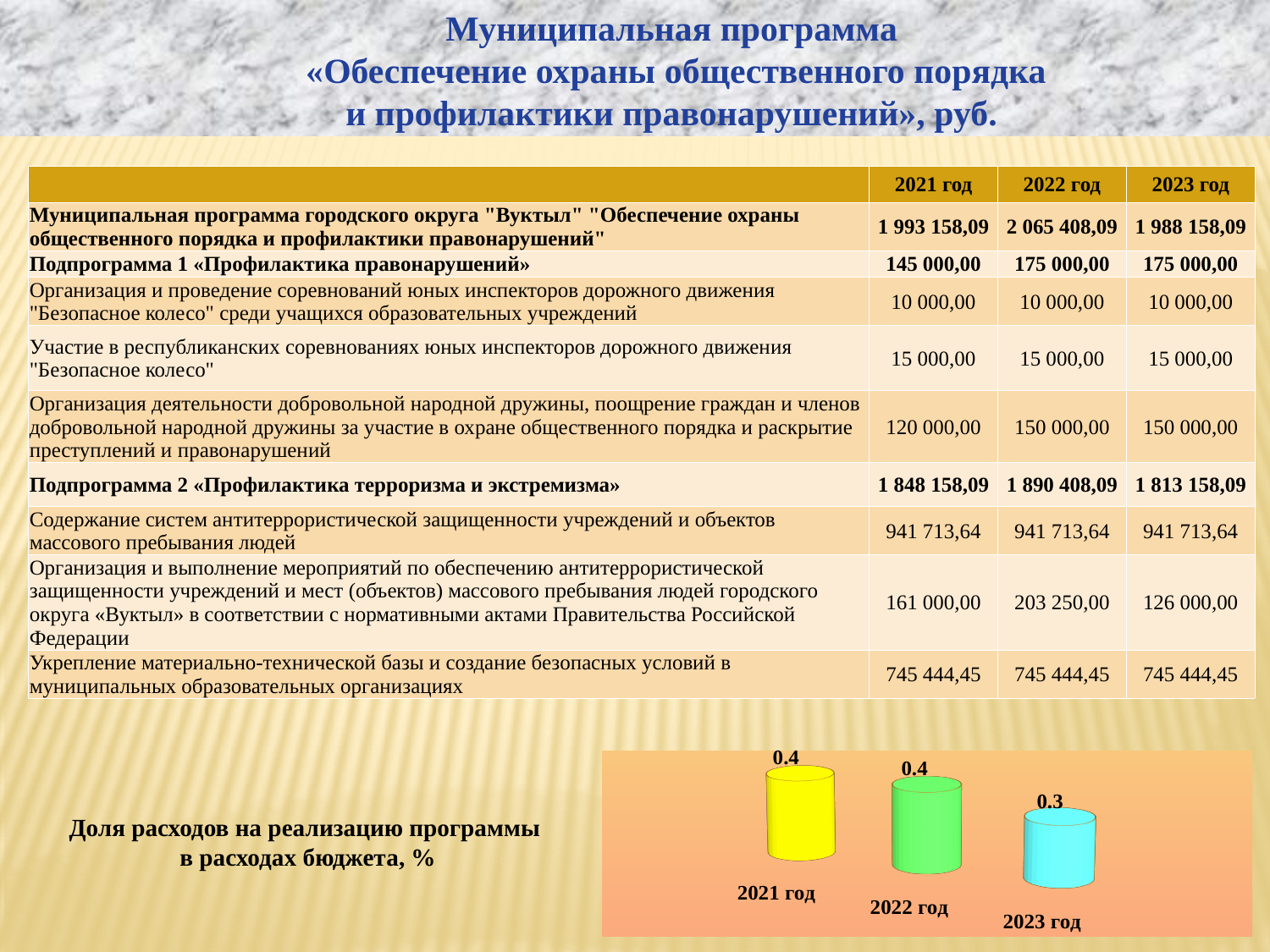
What colour is the bar for 2021 год? Yellow What kind of chart is shown at the bottom of the slide? Bar chart Which is larger, the value for 2022 год or the value for 2023 год? 2022 год How many categories are plotted in the chart? 3 What is the difference between the values for 2021 год and 2023 год? 0.1 What is the value for 2021 год in the chart? 0.4 What does the chart show, according to the text to its left? Доля расходов на реализацию программы в расходах бюджета, % Which year has the lowest value in the chart? 2023 год What is the value for 2023 год in the chart? 0.3 Do the values in the chart rise or fall from 2021 год to 2023 год? Fall What is the value for 2022 год in the chart? 0.4